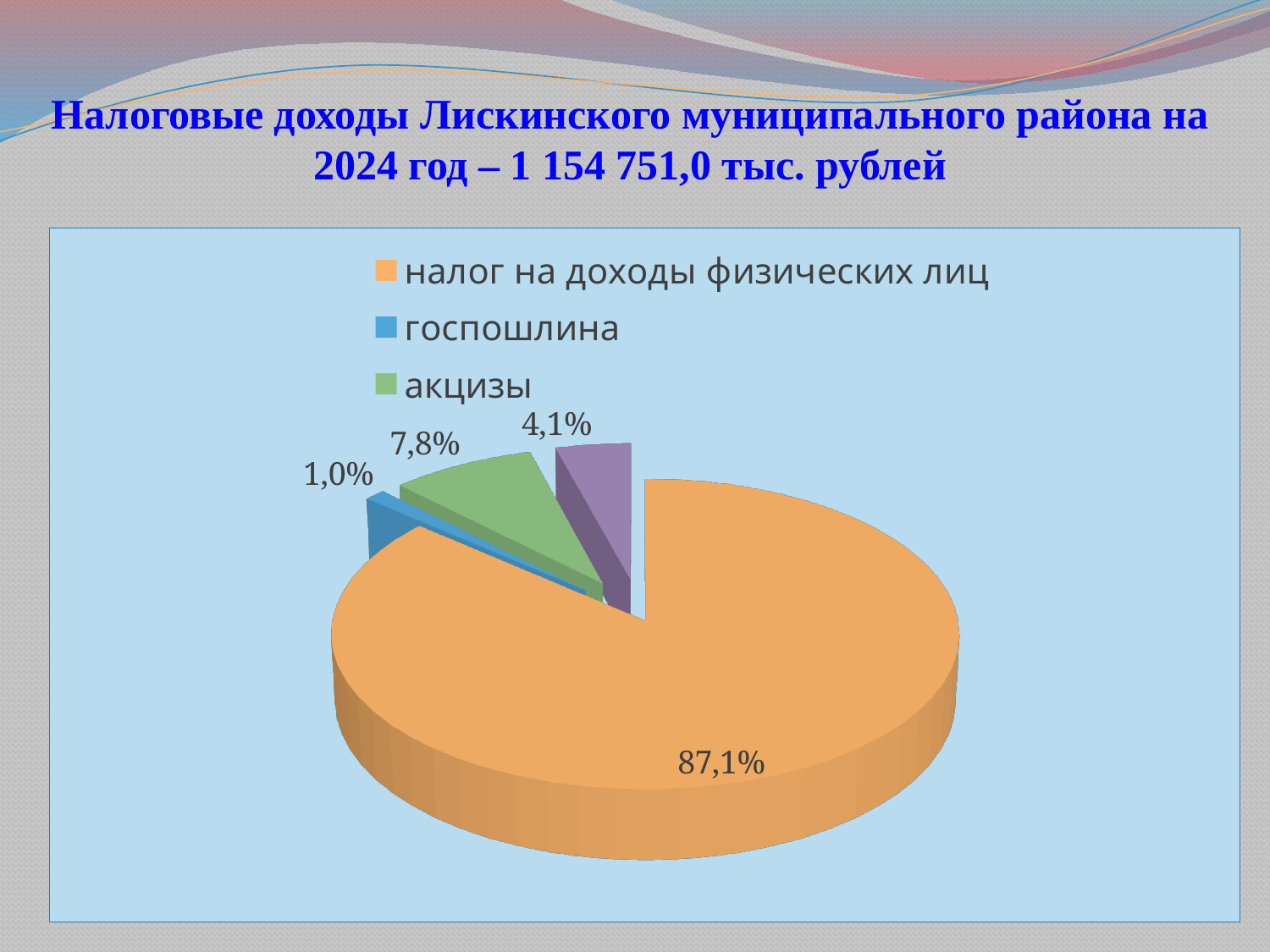
By how many percentage points does акцизы exceed госпошлина? 6,8 What total amount of tax revenue for 2024 is stated in the slide title? 1 154 751,0 тыс. рублей What percentage is shown for госпошлина? 1,0% Which category has the smallest slice of the pie? госпошлина How many entries does the legend list? 3 What share of the pie does налог на доходы физических лиц have? 87,1% Which category has the largest slice of the pie? налог на доходы физических лиц How many slices does the pie chart have? 4 By how many percentage points does налог на доходы физических лиц exceed акцизы? 79,3 What kind of chart is shown on the slide? pie chart Which is larger, the slice for акцизы or the slice for госпошлина? акцизы What percentage is shown for акцизы? 7,8%